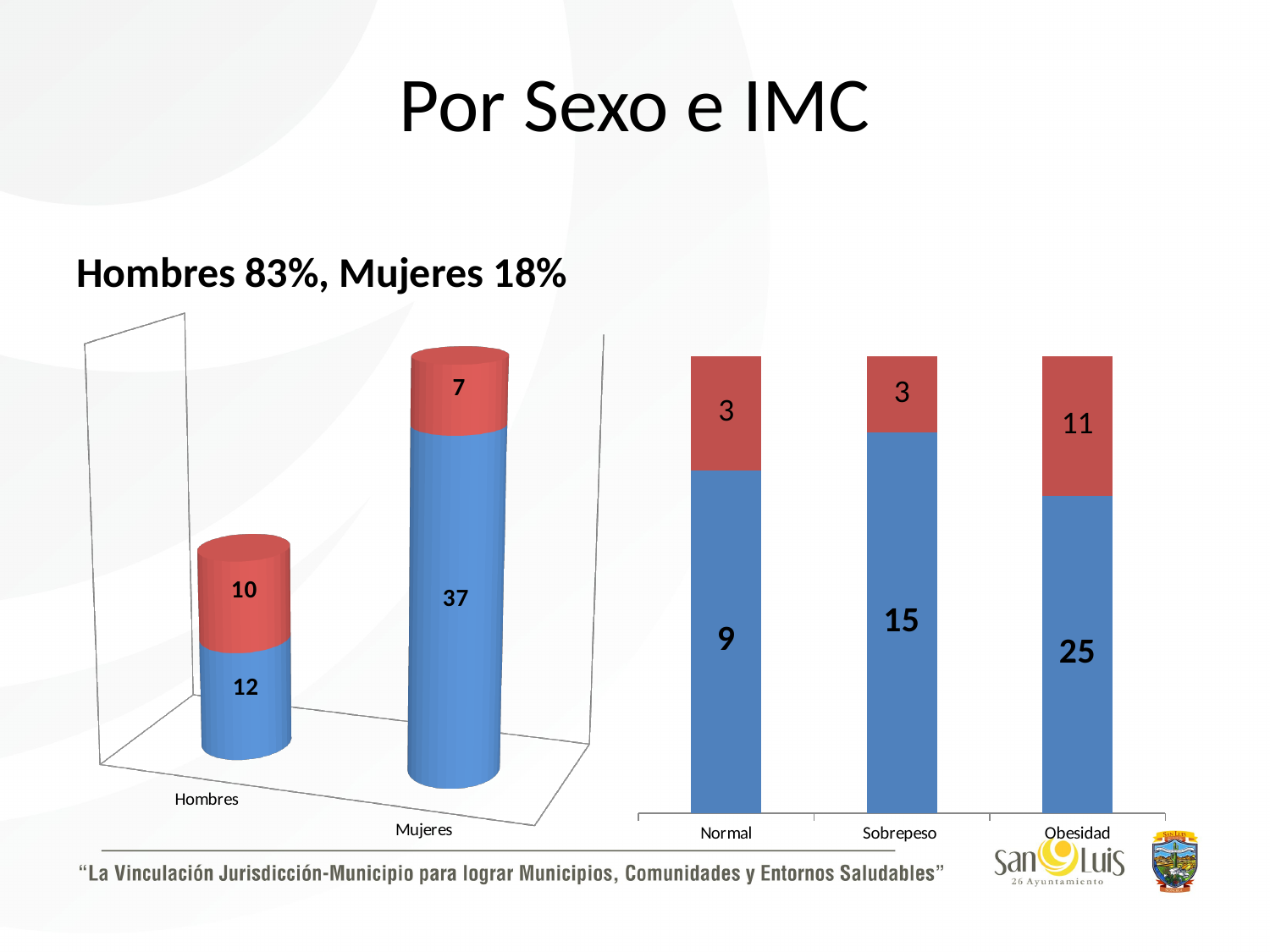
In the left chart, what is the value of the blue segment for Mujeres? 37 In the left chart, what is the value of the red segment for Hombres? 10 How many categories are shown on the x axis of the right chart? 3 In the right chart, which category has the highest blue segment value? Obesidad In the right chart, what is the value of the red segment for Sobrepeso? 3 What kind of chart is the right chart? Stacked bar chart In the left chart, which is larger: the blue segment for Mujeres or the blue segment for Hombres? Mujeres In the right chart, what is the value of the blue segment for Obesidad? 25 In the right chart, what is the difference between the blue segment values for Obesidad and Normal? 16 In the right chart, what is the total of the stacked bar for Obesidad? 36 In the left chart, what is the total of the stacked bar for Hombres? 22 In the left chart, what is the total of the stacked bar for Mujeres? 44